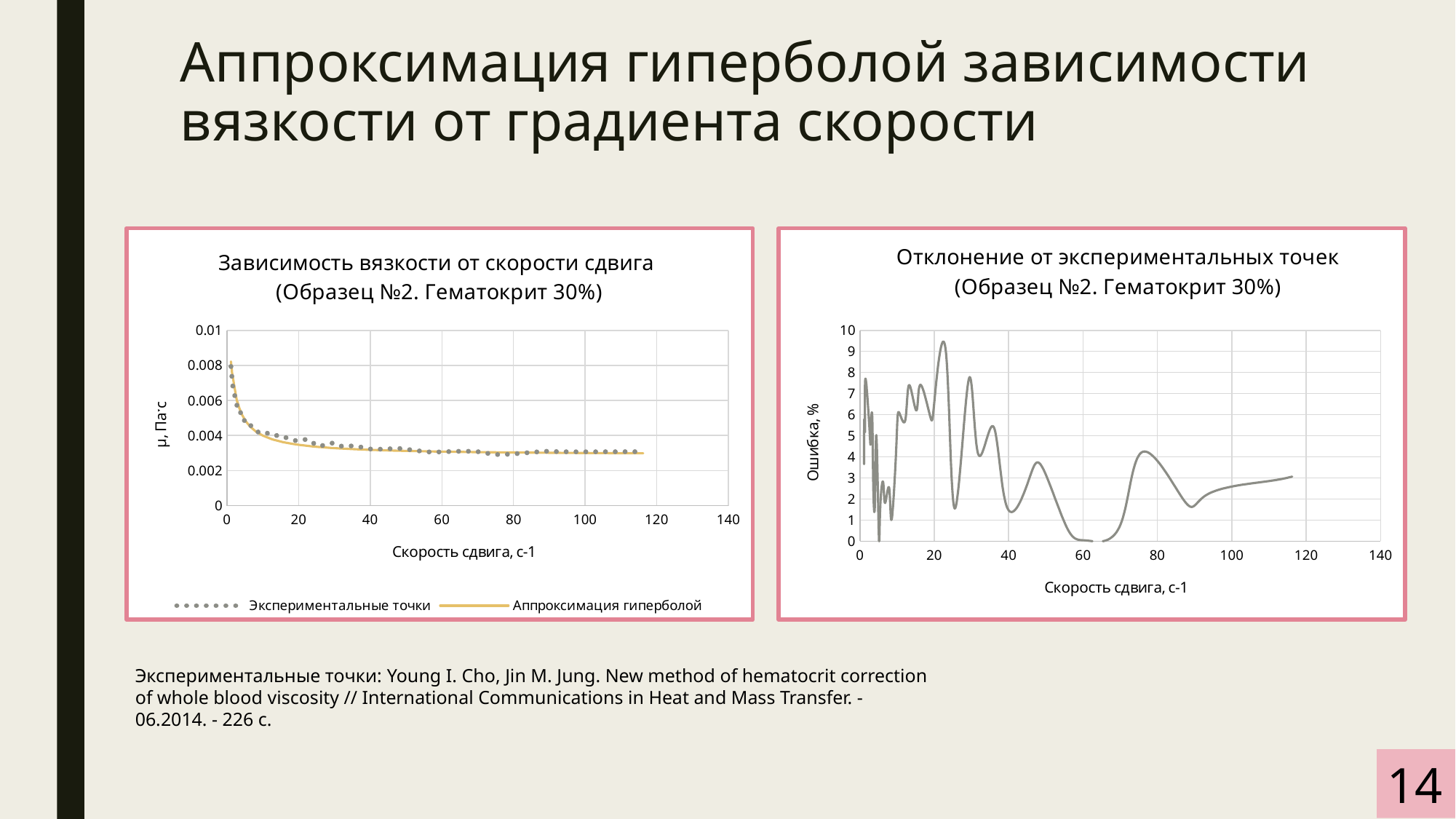
In the right-hand chart "Отклонение от экспериментальных точек", is the error value at a shear rate of 60 greater or less than 1? less In the left-hand chart "Зависимость вязкости от скорости сдвига", is the viscosity value at a shear rate of 100 greater or less than 0.004? less In the left-hand chart "Зависимость вязкости от скорости сдвига", is the viscosity value at a shear rate of 20 greater or less than 0.006? less What kind of chart is the right-hand chart titled "Отклонение от экспериментальных точек"? line chart What is the y-axis label of the right-hand chart "Отклонение от экспериментальных точек"? Ошибка, % In the left-hand chart "Зависимость вязкости от скорости сдвига", do the viscosity values rise or fall as the shear rate increases along the x axis? fall What are the two legend entries of the left-hand chart "Зависимость вязкости от скорости сдвига"? Экспериментальные точки; Аппроксимация гиперболой How many series does the legend of the left-hand chart "Зависимость вязкости от скорости сдвига" list? 2